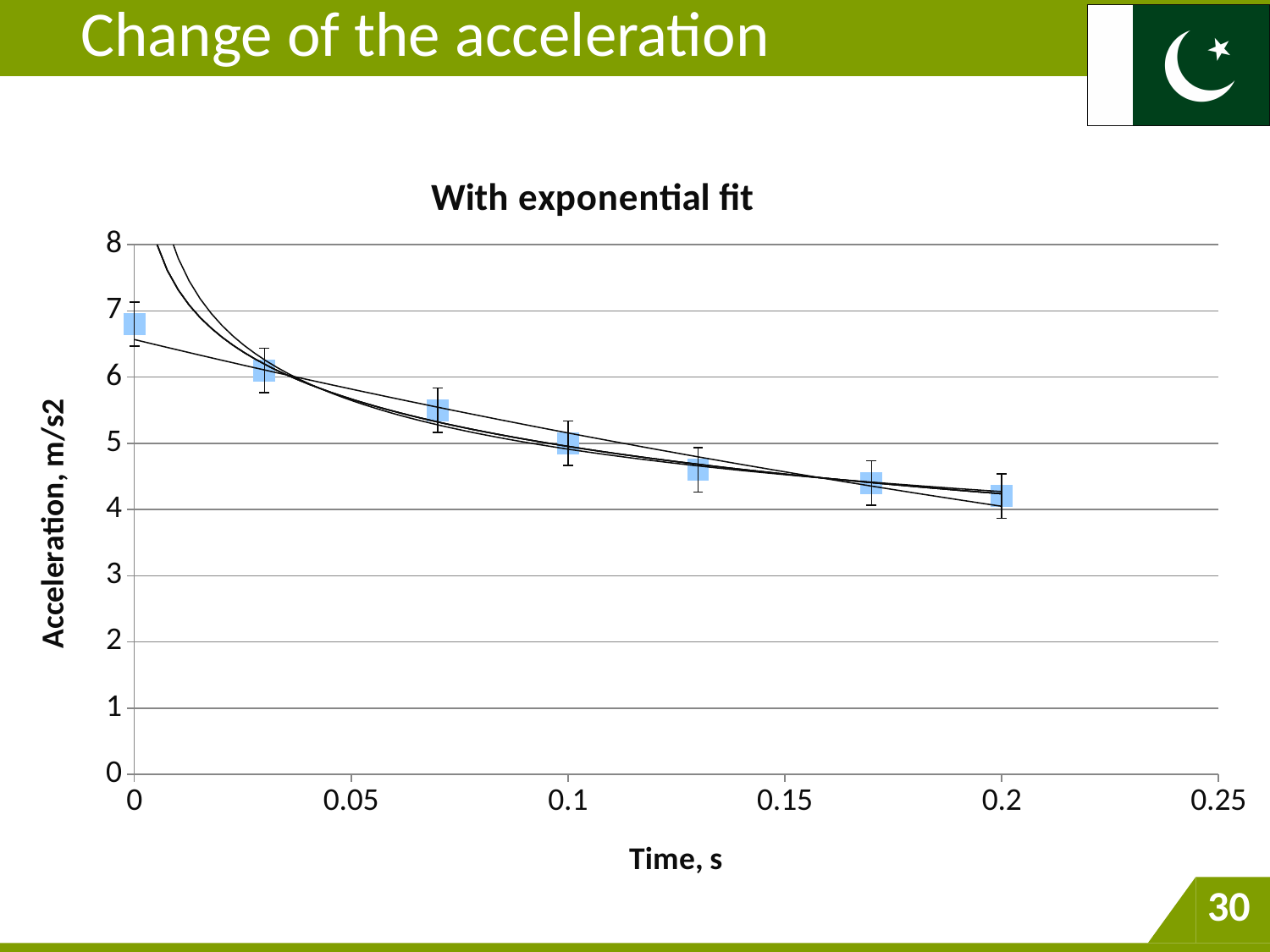
Is the acceleration value at time 0.13 greater or less than 5? less What is the title of the chart? With exponential fit Which has the larger acceleration value, the point at time 0.03 or the point at time 0.13? time 0.03 Is the acceleration value at time 0.2 greater or less than 5? less What kind of chart is shown on the slide? scatter chart Which has the larger acceleration value, the point at time 0 or the point at time 0.2? time 0 Is the acceleration value at time 0.07 greater or less than 5? greater How many data points are plotted in the chart? 7 Do the plotted acceleration values rise or fall as time increases? fall What is the label of the y axis? Acceleration, m/s2 At which time is the plotted acceleration highest? 0